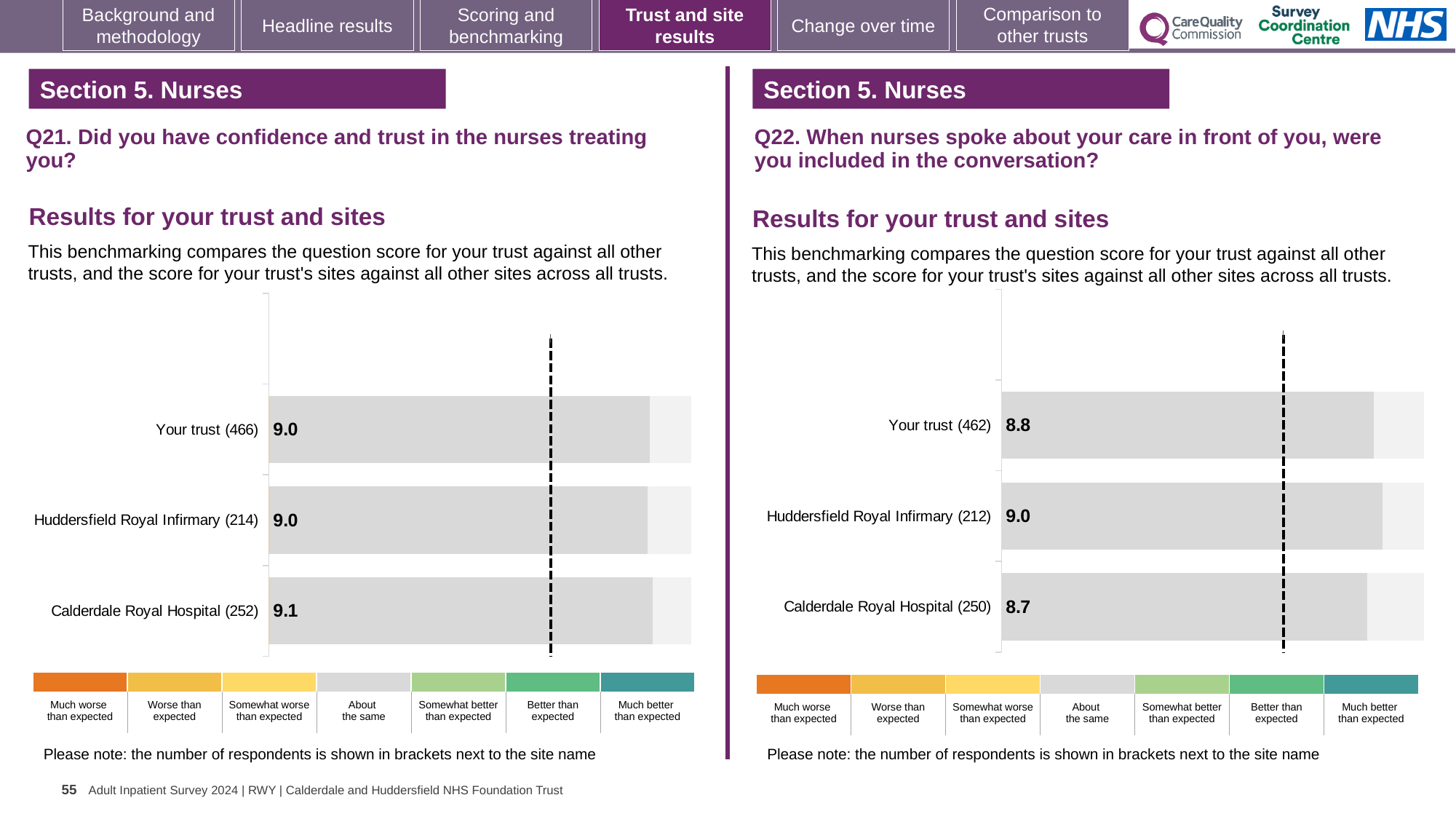
In the Q21 chart (left), how many bars are plotted? 3 In the Q22 chart (right), which has the larger score, Your trust or Huddersfield Royal Infirmary? Huddersfield Royal Infirmary In the Q22 chart (right), what is the score for Calderdale Royal Hospital? 8.7 In the Q21 chart (left), what is the score for Your trust? 9.0 In the Q22 chart (right), which site or trust has the lowest score? Calderdale Royal Hospital In the Q22 chart (right), what is the difference between the scores for Huddersfield Royal Infirmary and Calderdale Royal Hospital? 0.3 In the Q22 chart (right), what is the score for Your trust? 8.8 What kind of chart is used on the left for Q21? Bar chart In the Q22 chart (right), how many respondents are shown in brackets for Your trust? 462 In the Q21 chart (left), which site or trust has the highest score? Calderdale Royal Hospital In the Q21 chart (left), what is the score for Calderdale Royal Hospital? 9.1 In the Q22 chart (right), what is the score for Huddersfield Royal Infirmary? 9.0